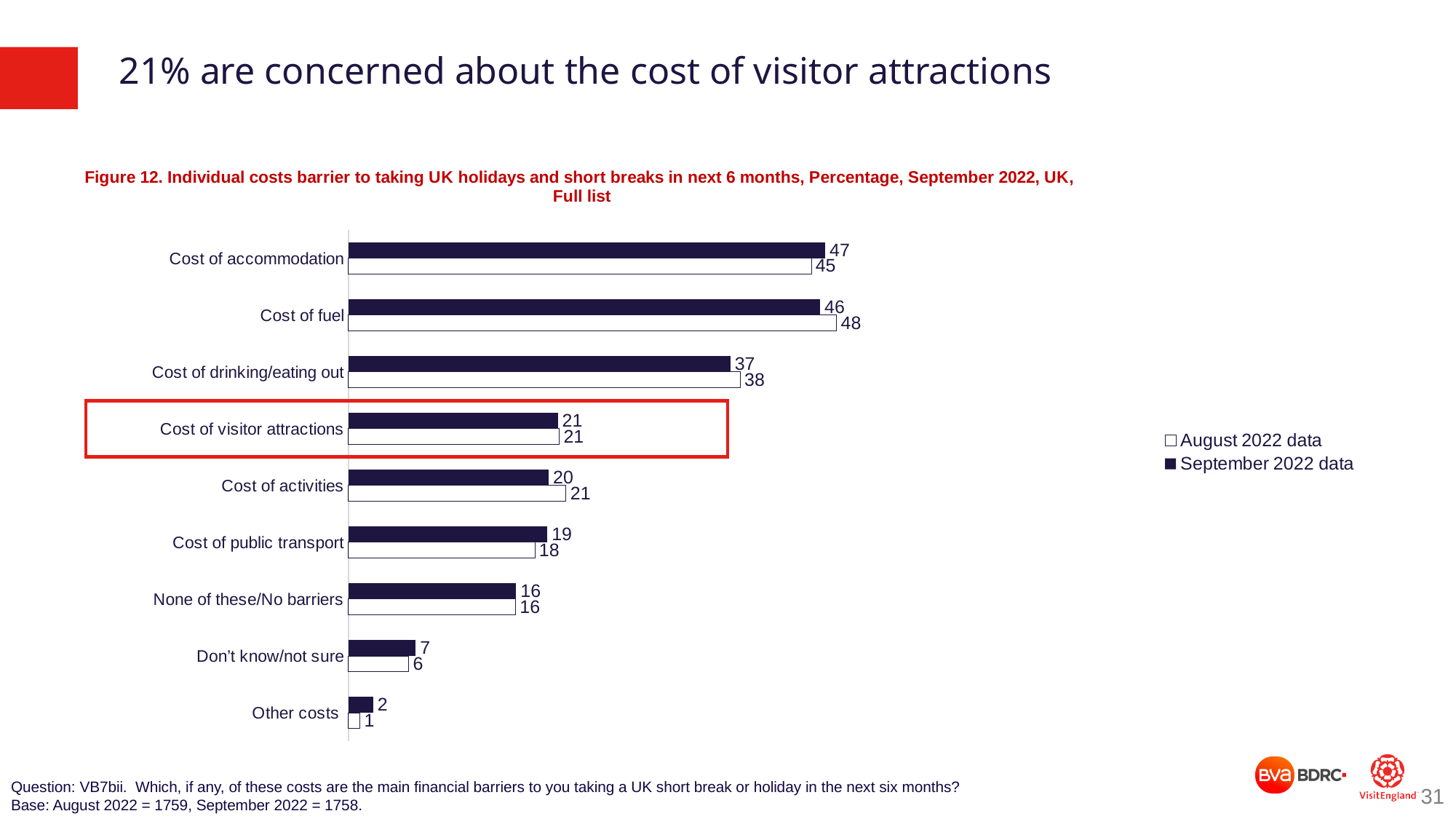
Which is larger for Cost of public transport: the August 2022 value or the September 2022 value? September 2022 data How many series does the legend list? 2 What is the September 2022 value for Cost of accommodation? 47 Which category has the highest September 2022 value? Cost of accommodation What is the difference between the August 2022 and September 2022 values for Cost of fuel? 2 Which category has the lowest August 2022 value? Other costs How many categories are shown on the chart? 9 What kind of chart is shown on the slide? Bar chart What is the August 2022 value for Cost of fuel? 48 What is the September 2022 value for Cost of drinking/eating out? 37 What is the August 2022 value for Cost of activities? 21 Which series is shown with the dark filled bars? September 2022 data